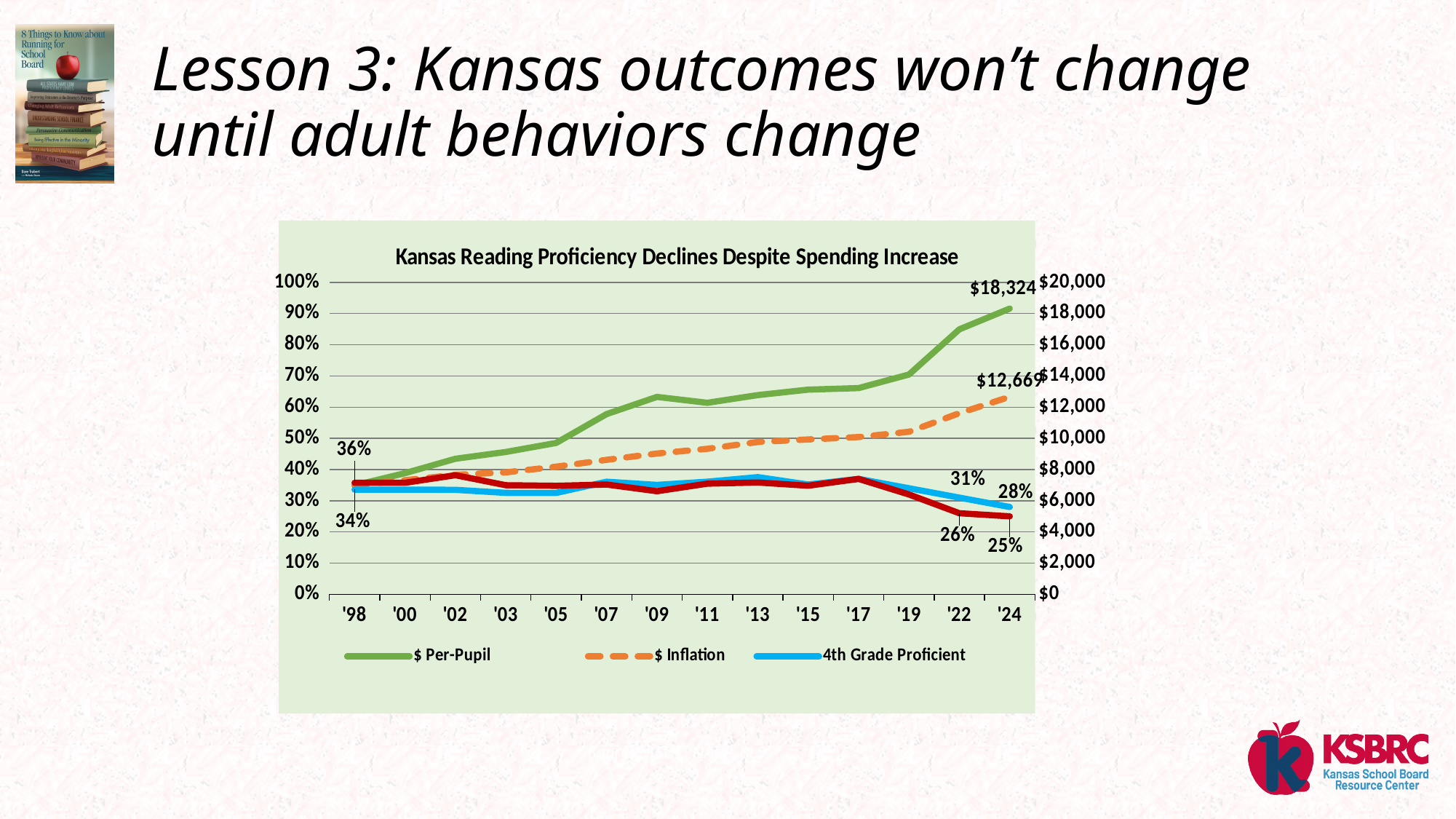
What is the title of the chart? Kansas Reading Proficiency Declines Despite Spending Increase What is the 4th Grade Proficient value in '24? 28% How many series does the chart legend list? 3 What is the $ Inflation value in '24? $12,669 What is the difference between the $ Per-Pupil and $ Inflation values in '24? $5,655 Does the $ Per-Pupil line generally rise or fall from '98 to '24? rise Which is larger in '24, $ Per-Pupil or $ Inflation? $ Per-Pupil What is the $ Per-Pupil value in '24? $18,324 By how much did the 4th Grade Proficient value fall from '98 to '24? 6% What is the 4th Grade Proficient value in '98? 34% What kind of chart is shown on the slide? line chart How many years are shown on the x axis? 14